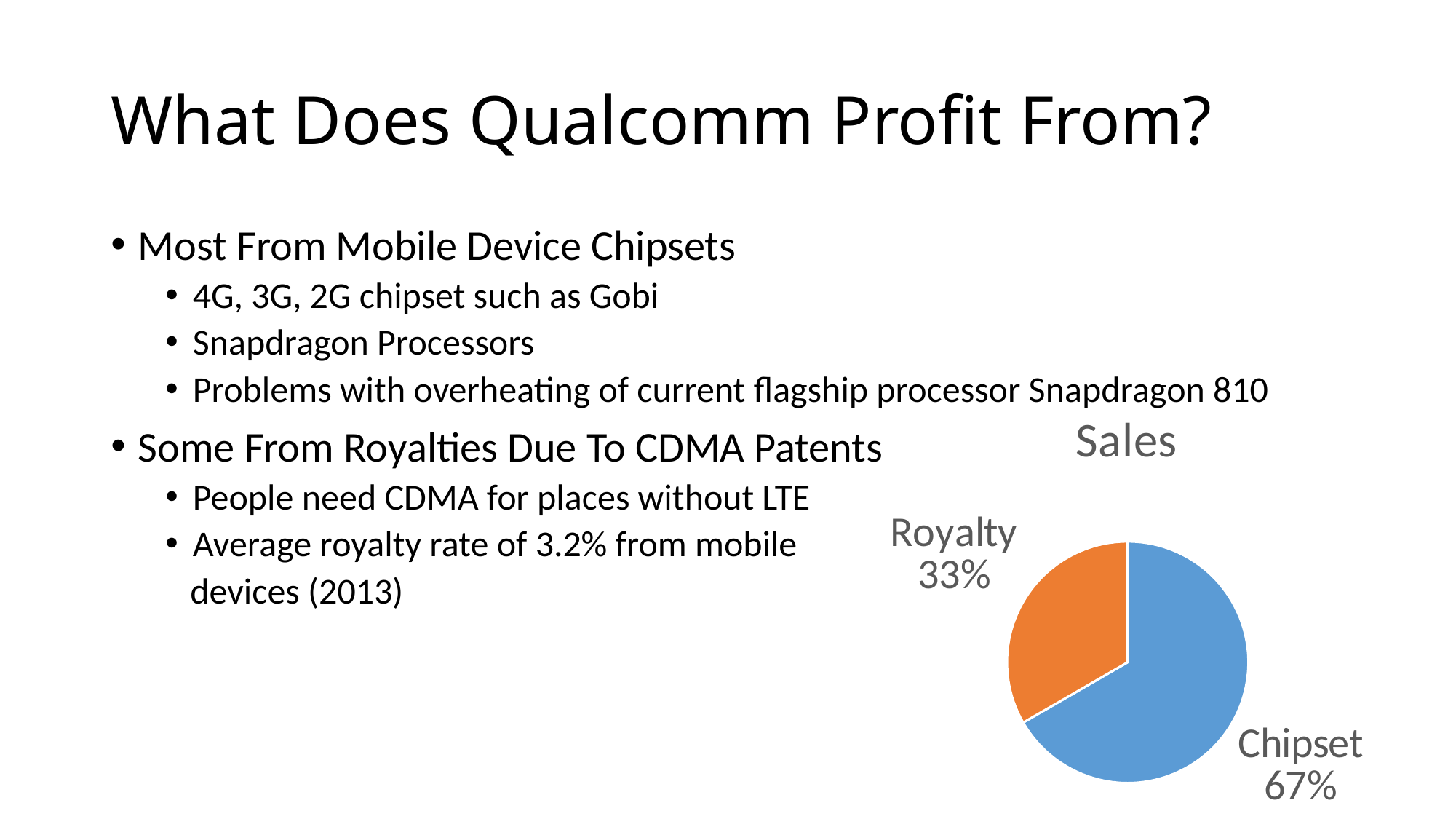
What colour is the Chipset slice in the Sales pie chart? blue How many slices does the Sales pie chart have? 2 Which slice of the Sales pie chart is the largest? Chipset What is the difference in percentage points between the Chipset and Royalty shares? 34 What kind of chart is shown on the slide? pie chart What share of Sales does Royalty account for? 33% Which slice of the Sales pie chart is the smallest? Royalty Which is larger in the Sales pie chart, Chipset or Royalty? Chipset What is the title of the chart on the slide? Sales What share of Sales does Chipset account for? 67%